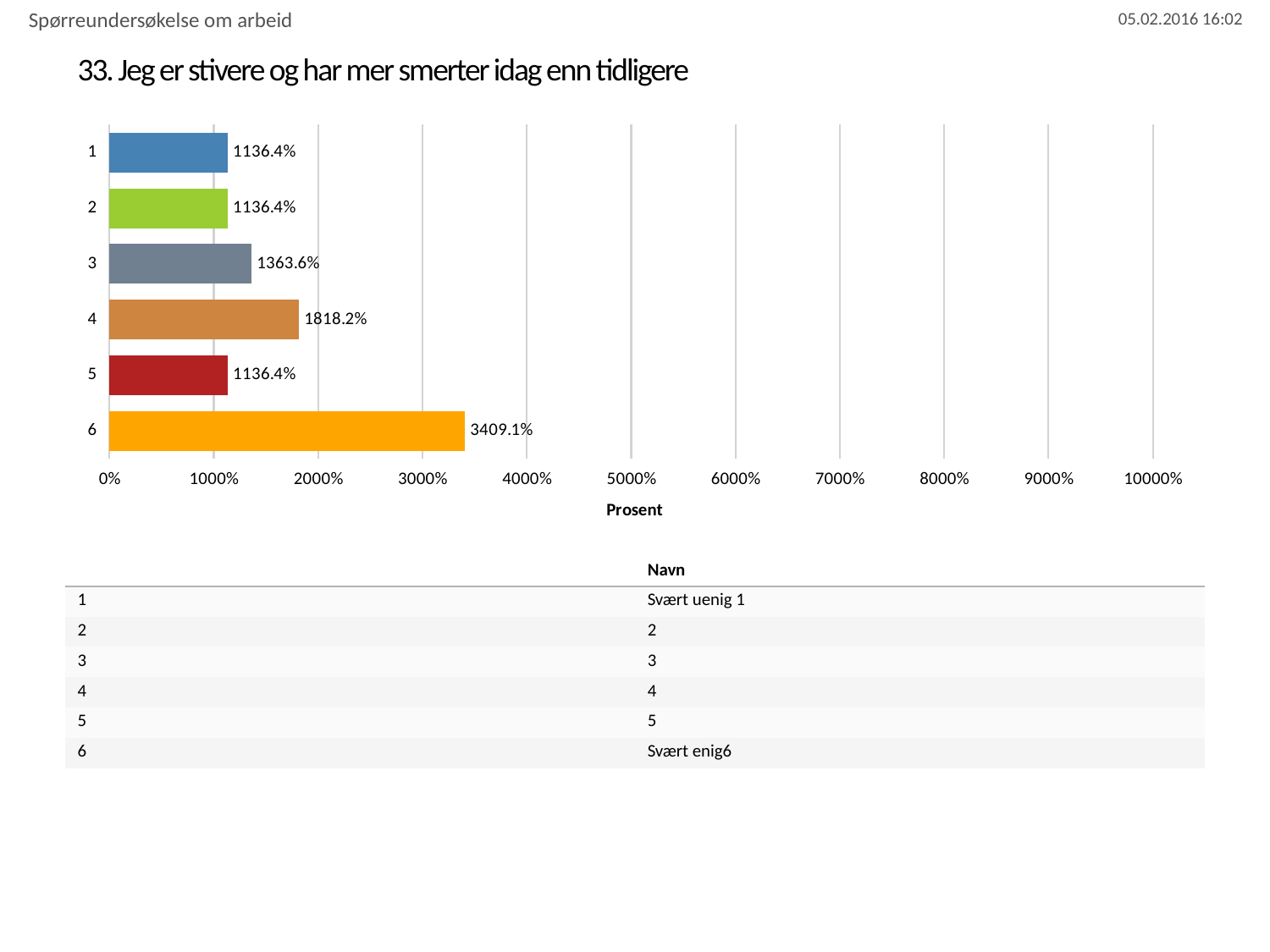
What is the value for category 6? 3409.1% Is the value for category 5 greater or less than 2000%? less Which is larger, the value for category 4 or the value for category 3? 4 Is the value for category 6 greater or less than 3000%? greater Which category has the highest value? 6 What is the value for category 3? 1363.6% What is the value for category 4? 1818.2% How many categories are shown in the chart? 6 What is the difference between the values for category 3 and category 2? 227.2% What is the difference between the values for category 6 and category 4? 1590.9% What kind of chart is shown on the slide? bar chart What is the label of the horizontal axis? Prosent